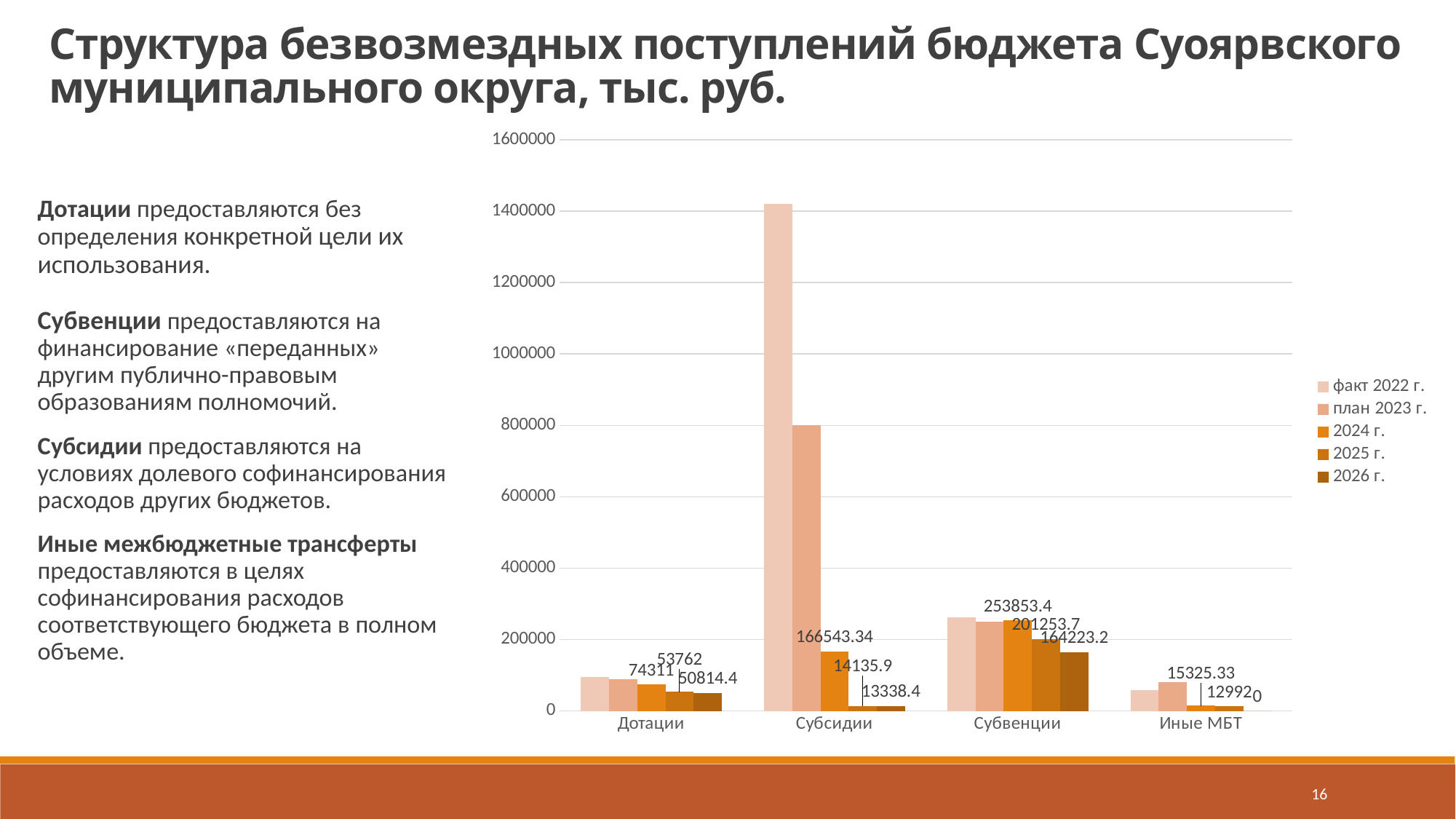
What is the value for Иные МБТ in the 2026 г. series? 0 How many series does the legend list? 5 Which is larger in the 2024 г. series: Дотации or Субсидии? Субсидии What is the value for Субвенции in the 2024 г. series? 253853.4 What is the value for Субсидии in the 2025 г. series? 14135.9 Which category has the lowest value in the 2026 г. series? Иные МБТ How many categories are shown on the x axis? 4 What kind of chart is shown on the slide? bar chart What is the value for Дотации in the 2026 г. series? 50814.4 What is the difference between the 2024 г. and 2025 г. values for Субвенции? 52599.7 Is the факт 2022 г. value for Субсидии greater or less than 1200000? greater Which category has the highest value in the 2024 г. series? Субвенции